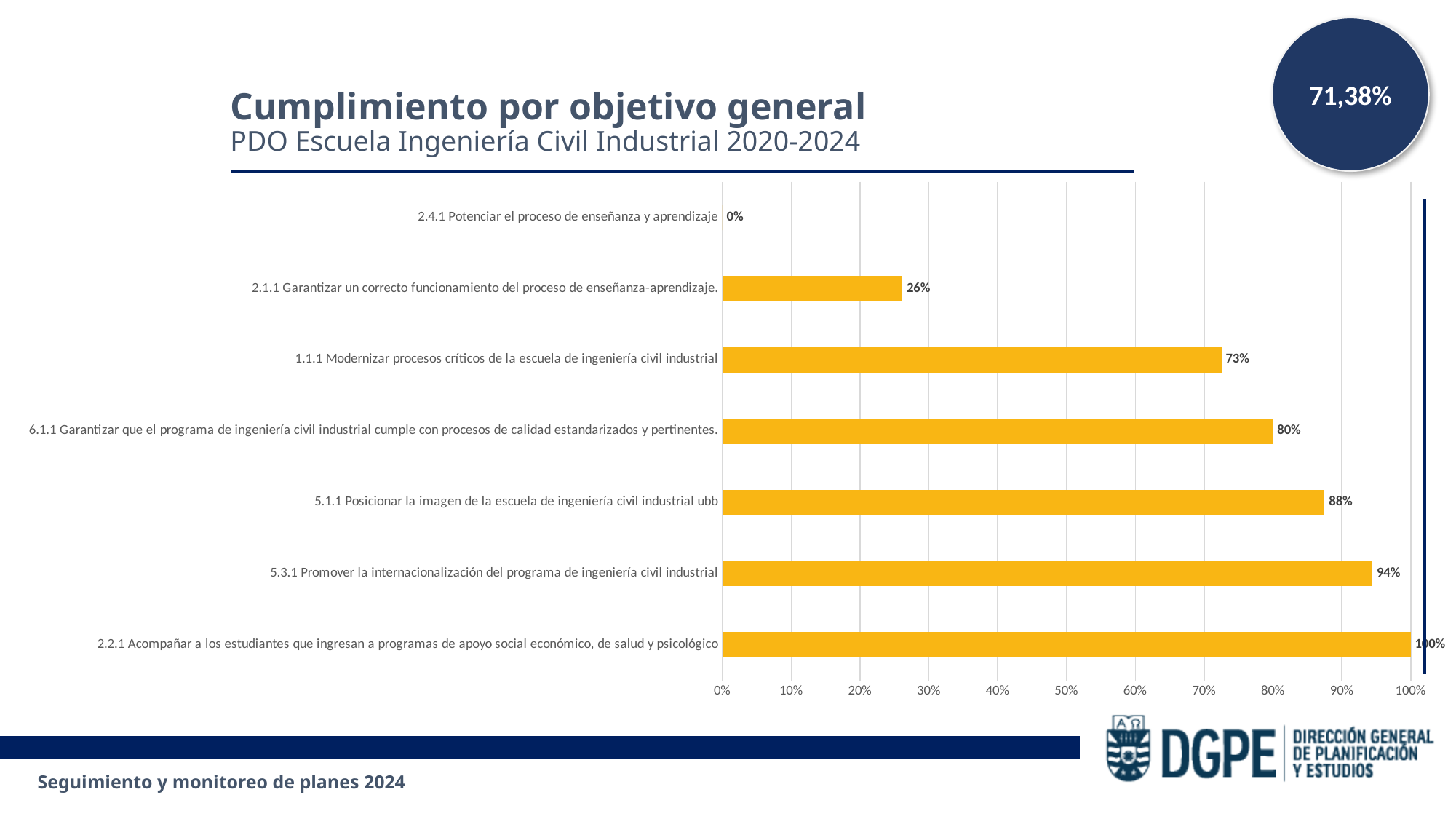
Is the value for 5.1.1 Posicionar la imagen de la escuela de ingeniería civil industrial ubb greater or less than 50%? greater What overall percentage is shown in the circle at the top right of the slide? 71,38% What is the difference between the values for 5.1.1 Posicionar la imagen de la escuela de ingeniería civil industrial ubb and 6.1.1 Garantizar que el programa de ingeniería civil industrial cumple con procesos de calidad estandarizados y pertinentes? 8% Which is larger, the value for 1.1.1 Modernizar procesos críticos or the value for 2.1.1 Garantizar un correcto funcionamiento del proceso de enseñanza-aprendizaje? 1.1.1 Modernizar procesos críticos What is the value for 5.3.1 Promover la internacionalización del programa de ingeniería civil industrial? 94% What kind of chart is shown on the slide? bar chart What is the value for 1.1.1 Modernizar procesos críticos de la escuela de ingeniería civil industrial? 73% Which objective has the highest value? 2.2.1 Acompañar a los estudiantes que ingresan a programas de apoyo social económico, de salud y psicológico How many objectives are shown in the chart? 7 What is the title of the chart on the slide? Cumplimiento por objetivo general What is the value for 2.1.1 Garantizar un correcto funcionamiento del proceso de enseñanza-aprendizaje? 26% Which objective has the lowest value? 2.4.1 Potenciar el proceso de enseñanza y aprendizaje